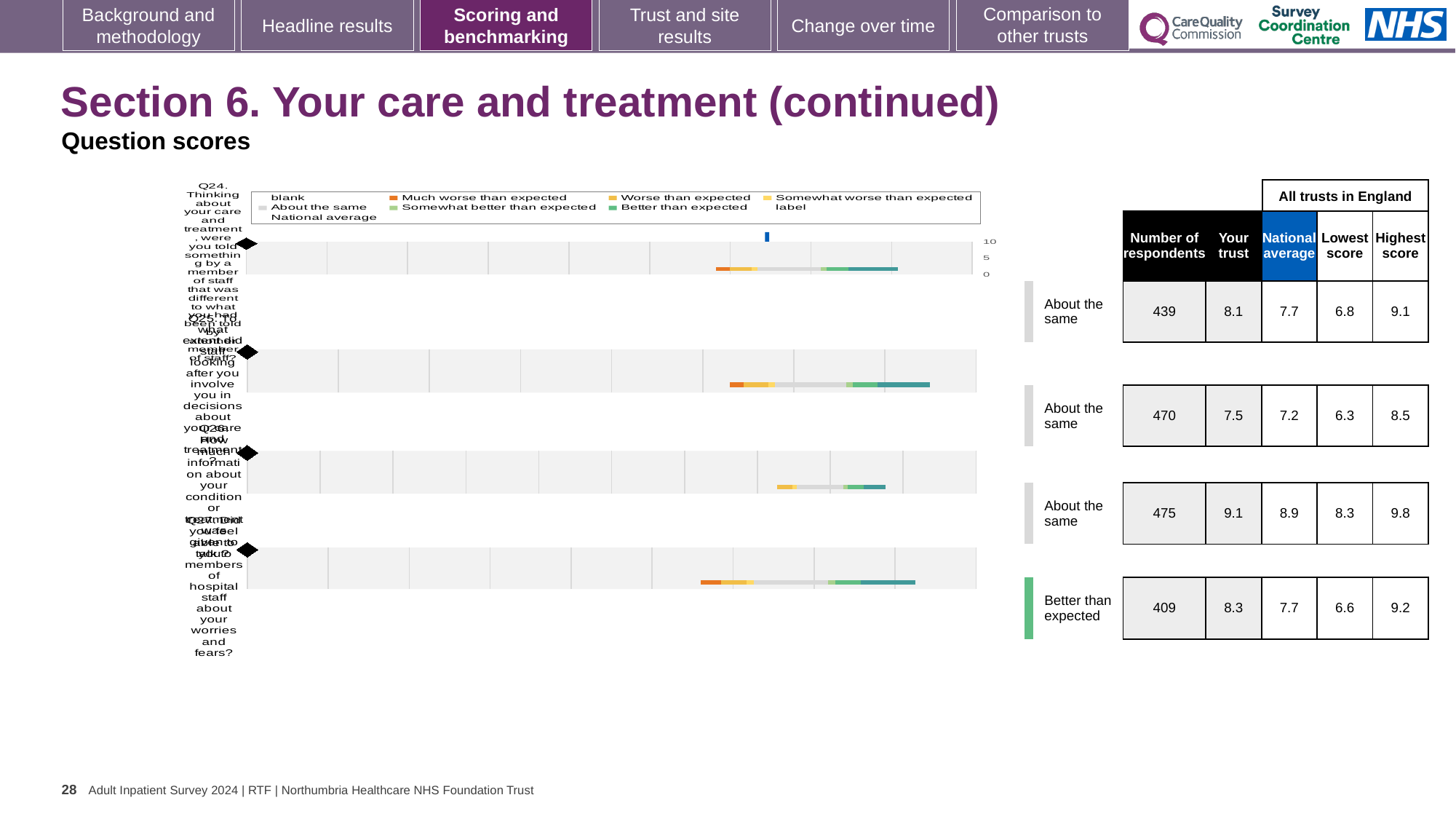
For Q24 (the first row), what is the difference between the 'Your trust' score and the national average? 0.4 How many respondents are shown for Q24 (the first row)? 439 How many question rows are shown on the slide? 4 Which question has the lowest 'Your trust' score? Q25 What is the 'Your trust' score for Q25 (the second row)? 7.5 Which question has the highest 'Your trust' score? Q26 What is the highest score across all trusts in England for Q27 (the fourth row)? 9.2 What is the lowest score across all trusts in England for Q25 (the second row)? 6.3 Which question is rated 'Better than expected'? Q27 What kind of chart is used for each question row? bar chart Which has the higher 'Your trust' score, Q24 or Q27? Q27 What is the national average for Q26 (the third row)? 8.9